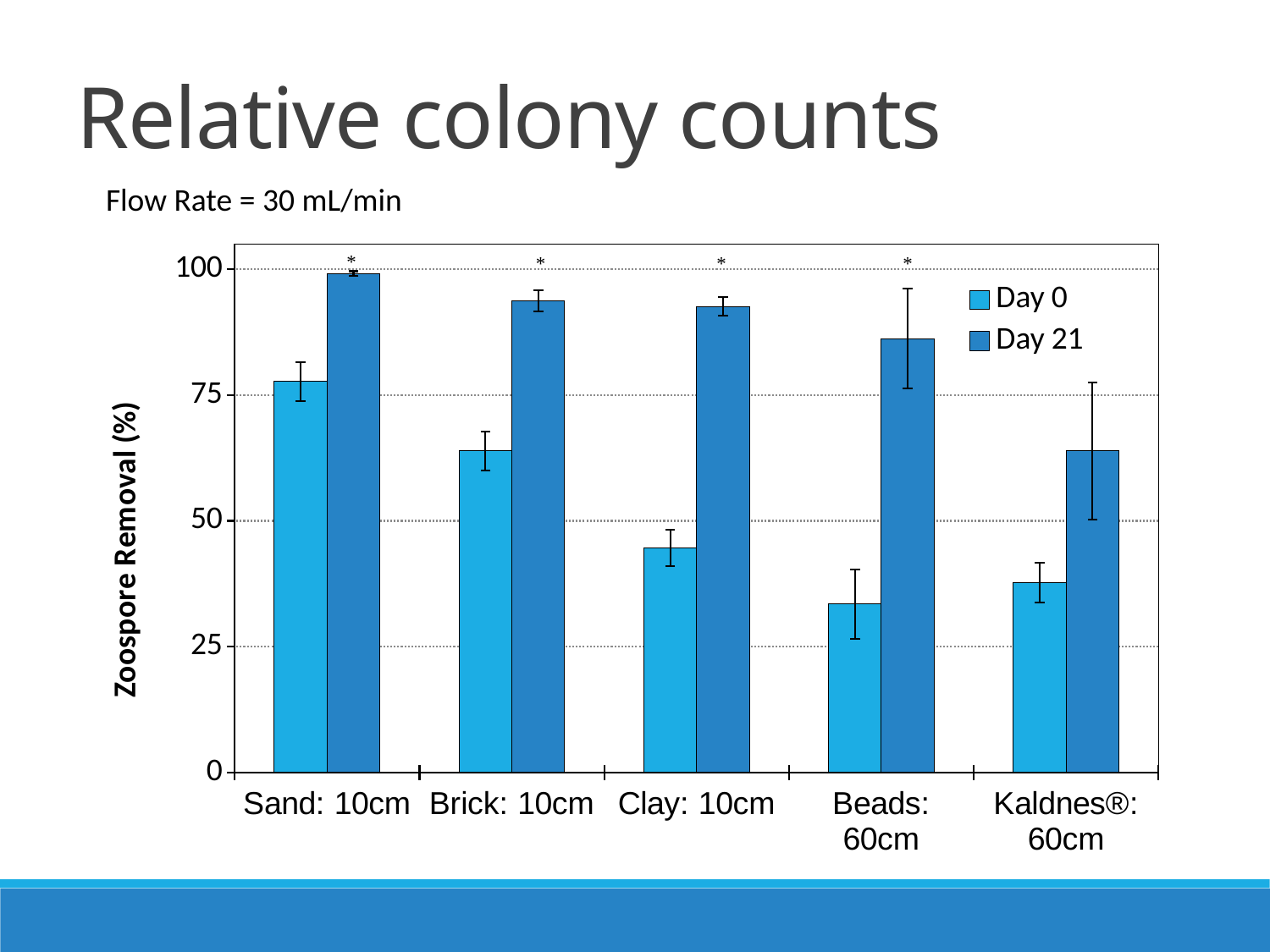
Which category has the highest Day 21 value? Sand: 10cm Is the Day 0 value for Brick: 10cm greater or less than 50? greater What is the label on the y axis? Zoospore Removal (%) Which category has the lowest Day 21 value? Kaldnes®: 60cm How many filter media categories are shown on the x axis? 5 What kind of chart is shown on the slide? bar chart Which category has the highest Day 0 value? Sand: 10cm How many series does the legend list? 2 Is the Day 21 value for Kaldnes®: 60cm greater or less than 50? greater Is the Day 0 value for Clay: 10cm greater or less than 50? less For Clay: 10cm, which is larger, the Day 0 value or the Day 21 value? Day 21